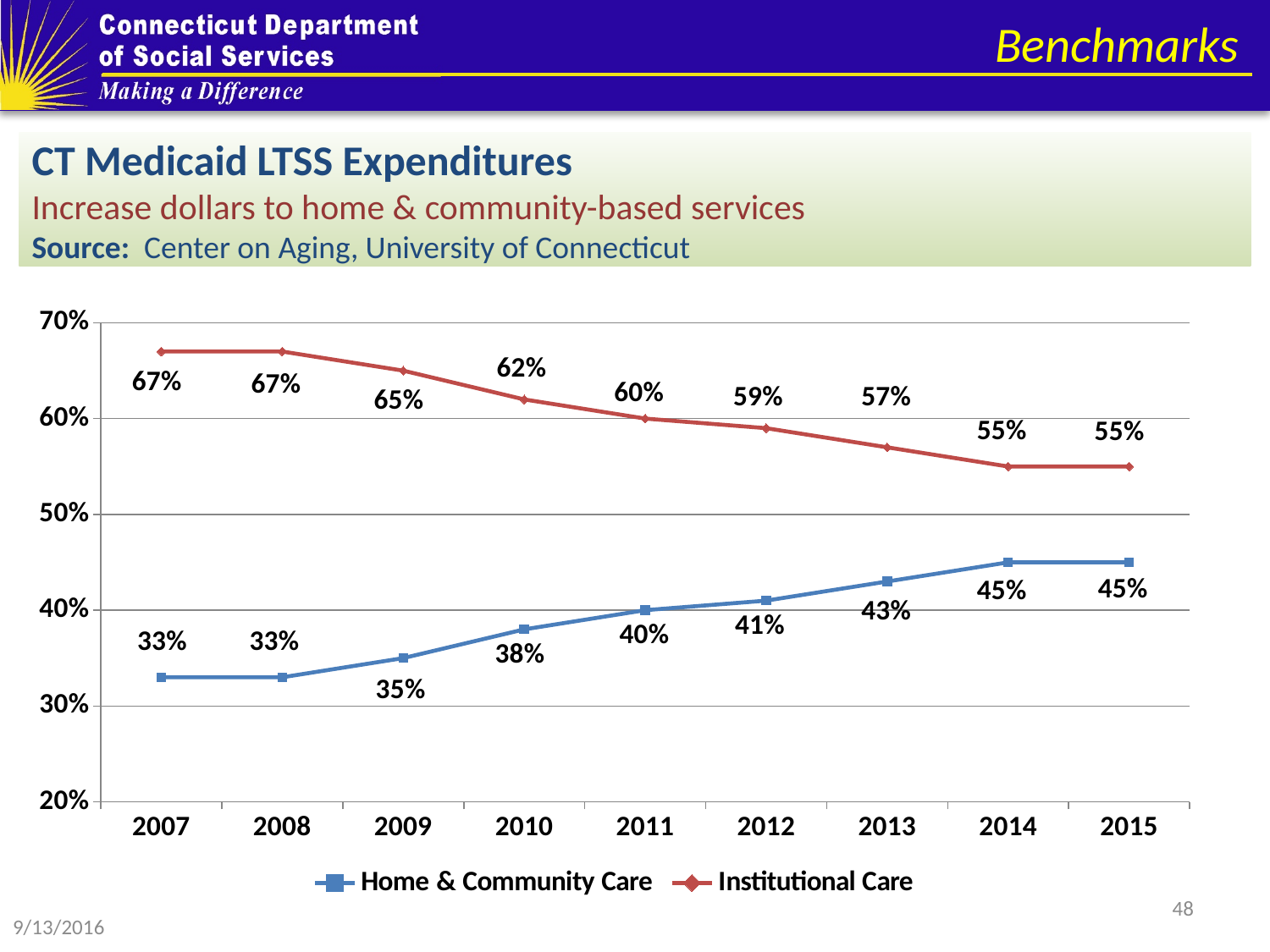
Does the Home & Community Care series rise or fall from 2007 to 2015? Rise What is the value for Home & Community Care in 2013? 43% How many series does the legend list? 2 In which year is Home & Community Care at its lowest value? 2007 and 2008 What is the value for Institutional Care in 2010? 62% Which series has the larger value in 2009, Home & Community Care or Institutional Care? Institutional Care What is the difference between Institutional Care and Home & Community Care in 2011? 20% How many years are shown on the x axis? 9 What is the value for Home & Community Care in 2007? 33% In which year is Institutional Care at its lowest value? 2014 and 2015 What is the difference between Institutional Care and Home & Community Care in 2015? 10% What kind of chart is shown on the slide? Line chart